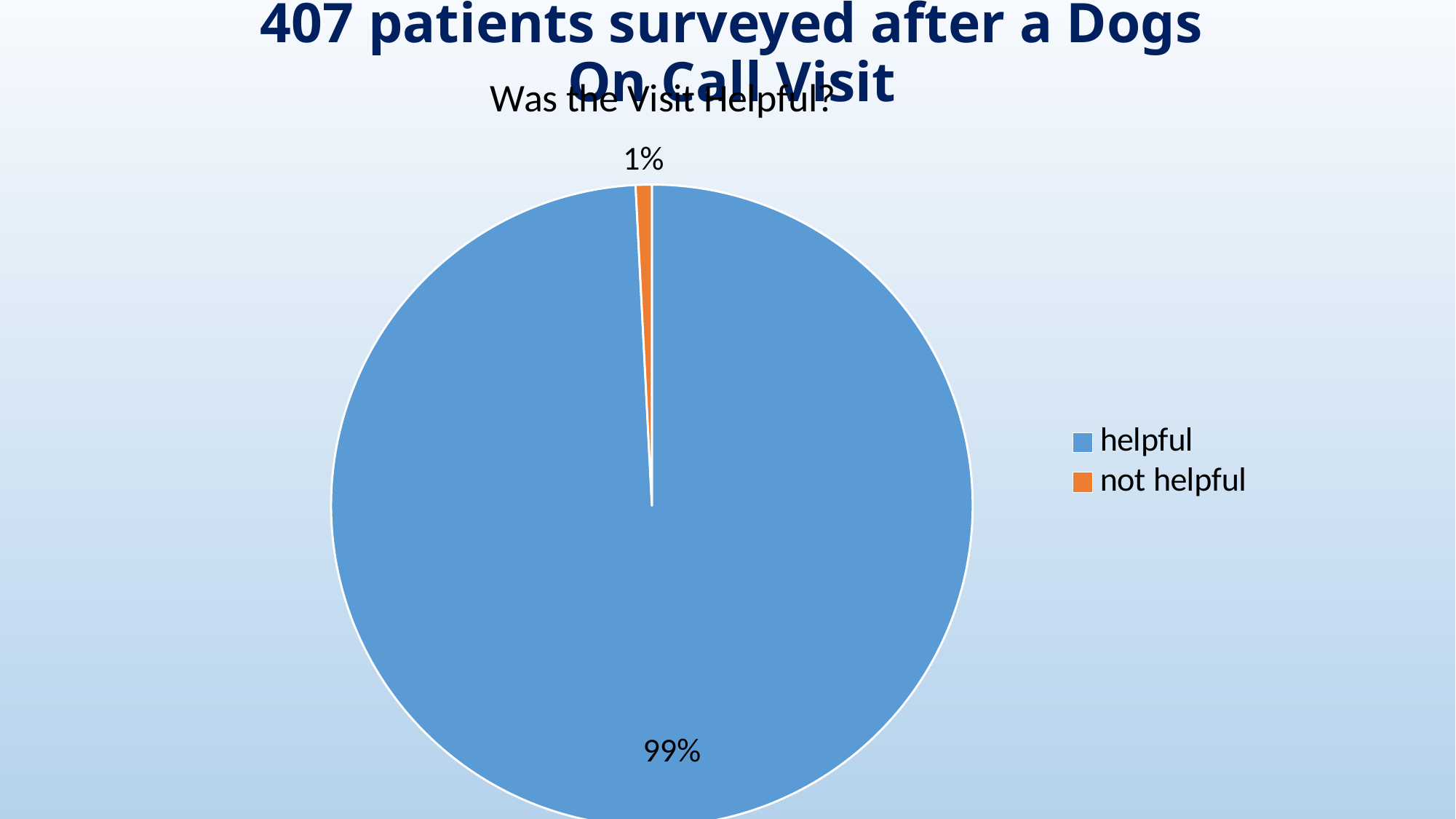
What is the title of the pie chart? Was the Visit Helpful? What kind of chart is shown on the slide? pie chart What share of the pie is labelled "not helpful"? 1% How many slices does the pie chart have? 2 What share of the pie is labelled "helpful"? 99% What is the difference in percentage points between the "helpful" and "not helpful" slices? 98 How many entries does the legend list? 2 Which slice of the pie is the largest? helpful Which is larger, the "helpful" slice or the "not helpful" slice? helpful What colour is the "not helpful" slice? orange Which slice of the pie is the smallest? not helpful